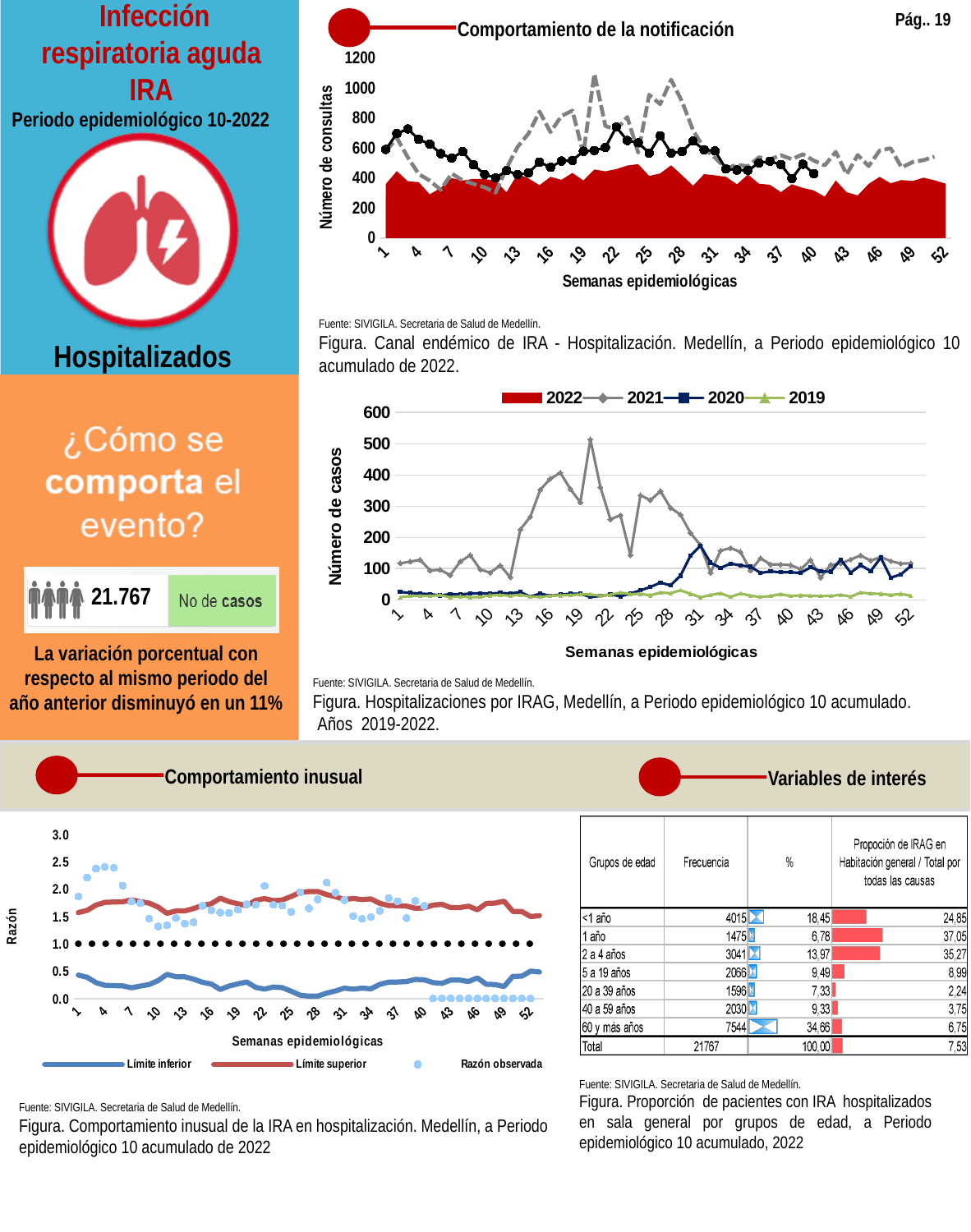
What is the x-axis label of the chart 'Comportamiento de la notificación' (top right)? Semanas epidemiológicas In the table 'Proporción de pacientes con IRA hospitalizados en sala general por grupos de edad' (bottom right), which age group has the highest Frecuencia? 60 y más años In the chart 'Hospitalizaciones por IRAG' (middle right), is the value of the 2019 series at week 28 greater or less than 100? less How many series does the legend list in the chart 'Comportamiento inusual de la IRA en hospitalización' (bottom left)? 3 In the chart 'Hospitalizaciones por IRAG' (middle right), which years are listed in the legend? 2022, 2021, 2020, 2019 In the chart 'Comportamiento inusual de la IRA en hospitalización' (bottom left), is the 'Límite inferior' value at week 1 greater or less than 1.0? less In the table 'Proporción de pacientes con IRA hospitalizados en sala general por grupos de edad' (bottom right), what is the difference in Frecuencia between '<1 año' and '2 a 4 años'? 974 In the table 'Proporción de pacientes con IRA hospitalizados en sala general por grupos de edad' (bottom right), which age group has the lowest Frecuencia? 1 año How many series does the legend list in the chart titled 'Hospitalizaciones por IRAG, Medellín, a Periodo epidemiológico 10 acumulado. Años 2019-2022'? 4 In the chart 'Comportamiento inusual de la IRA en hospitalización' (bottom left), is the 'Razón observada' value at week 4 greater or less than 2.0? greater In the table 'Proporción de pacientes con IRA hospitalizados en sala general por grupos de edad' (bottom right), what is the Frecuencia for '60 y más años'? 7544